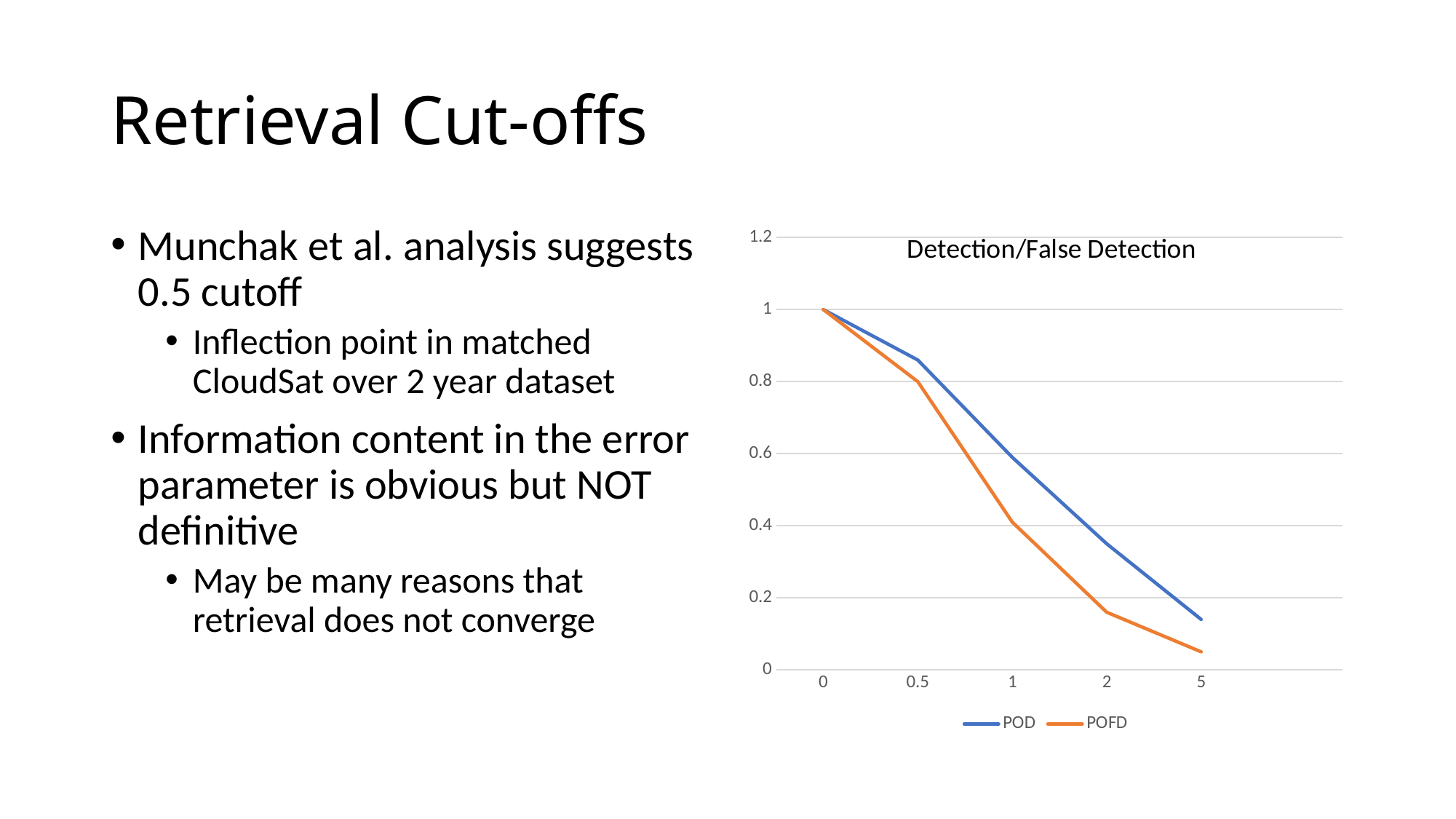
How many points are plotted along the x axis for each series? 5 What is the value of POD at x = 0? 1 What is the value of POFD at x = 0? 1 Is the value of POFD at x = 5 greater or less than 0.2? less Is the value of POD at x = 0.5 greater or less than 0.8? greater How many series does the legend list? 2 What is the title of the chart? Detection/False Detection Do the POD values rise or fall as x increases from 0 to 5? fall Which series is drawn in orange? POFD Is the value of POFD at x = 1 greater or less than 0.6? less What kind of chart is shown on the slide? line chart At x = 2, which series has the larger value, POD or POFD? POD